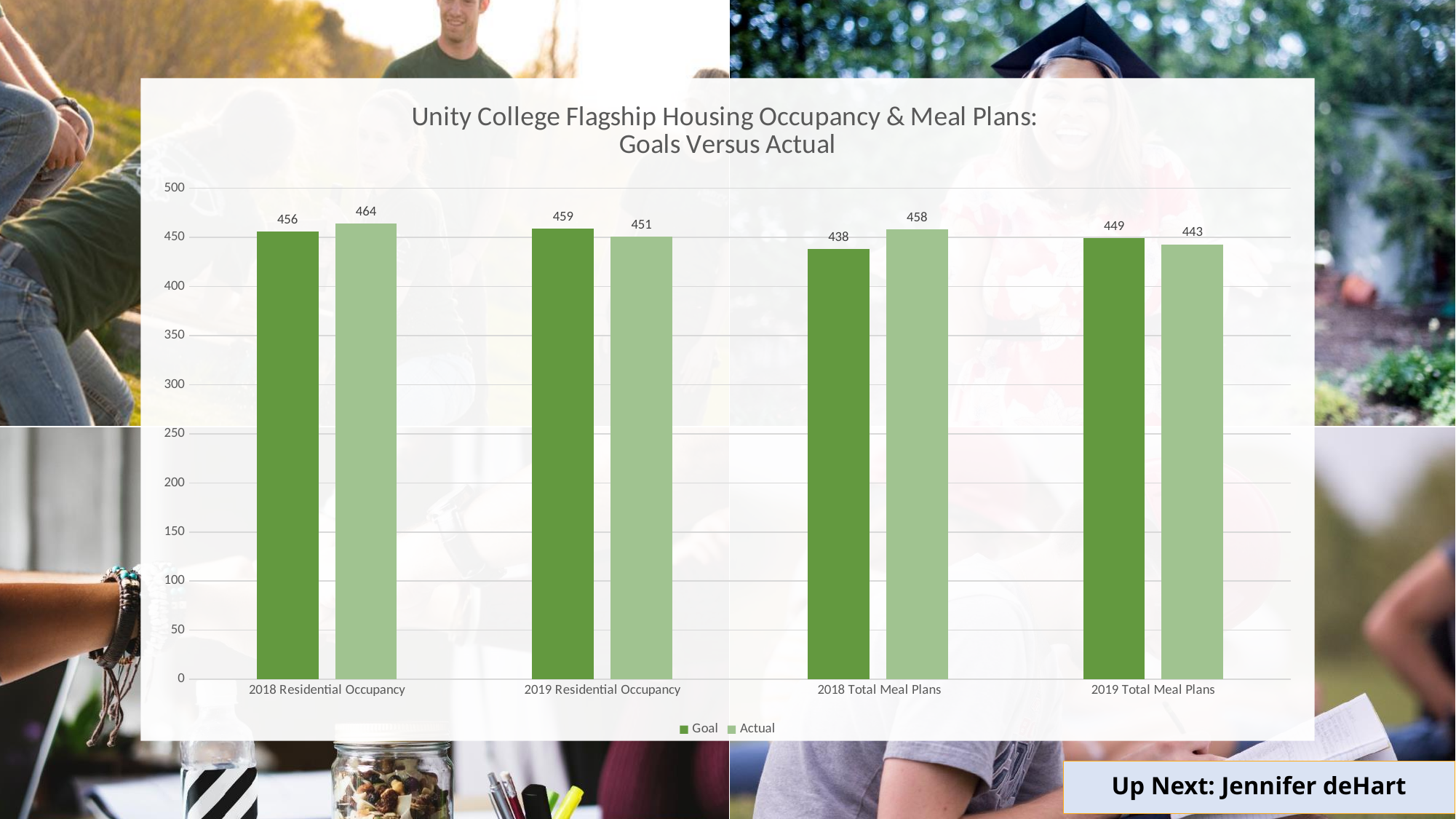
How many categories are shown on the x axis? 4 How many series does the legend list? 2 What is the difference between the Goal and Actual values for 2019 Residential Occupancy? 8 What is the Goal value for 2018 Residential Occupancy? 456 What is the title of the chart? Unity College Flagship Housing Occupancy & Meal Plans: Goals Versus Actual Which category has the lowest Goal value? 2018 Total Meal Plans For 2019 Total Meal Plans, which is larger, the Goal or the Actual value? Goal Which category has the highest Actual value? 2018 Residential Occupancy What kind of chart is shown on the slide? Bar chart What is the Actual value for 2018 Total Meal Plans? 458 What is the Actual value for 2019 Total Meal Plans? 443 What is the difference between the Actual and Goal values for 2018 Total Meal Plans? 20